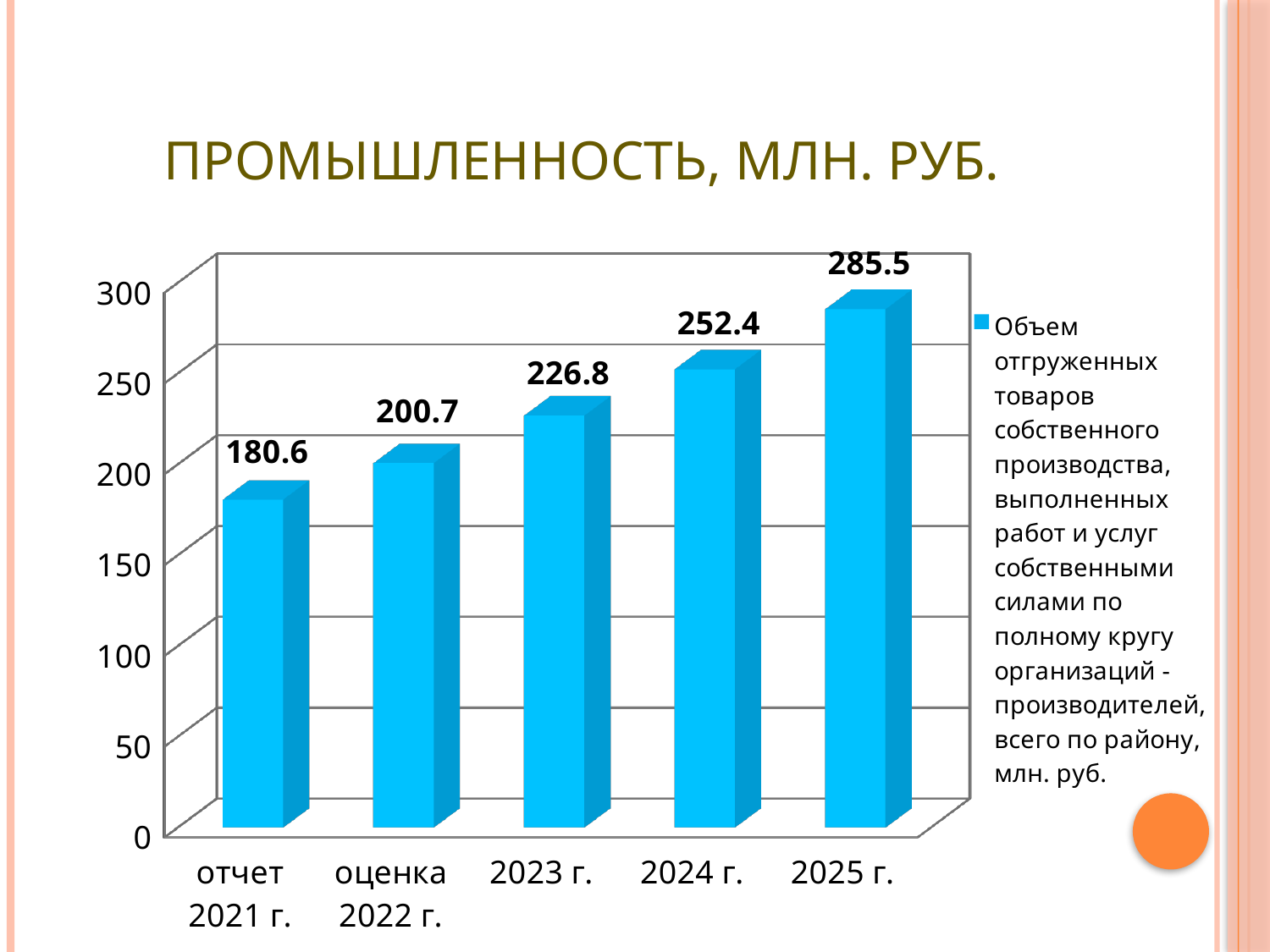
Which category has the lowest value? отчет 2021 г. What is the difference between the values for оценка 2022 г. and отчет 2021 г.? 20.1 What kind of chart is shown on the slide? bar chart Do the values rise or fall from отчет 2021 г. to 2025 г.? rise What is the value for 2023 г.? 226.8 What is the value for отчет 2021 г.? 180.6 What is the value for 2025 г.? 285.5 Which category has the highest value? 2025 г. What is the difference between the values for 2025 г. and 2024 г.? 33.1 How many series does the legend list? 1 How many categories are shown on the x axis? 5 Which is larger, the value for 2024 г. or the value for 2023 г.? 2024 г.